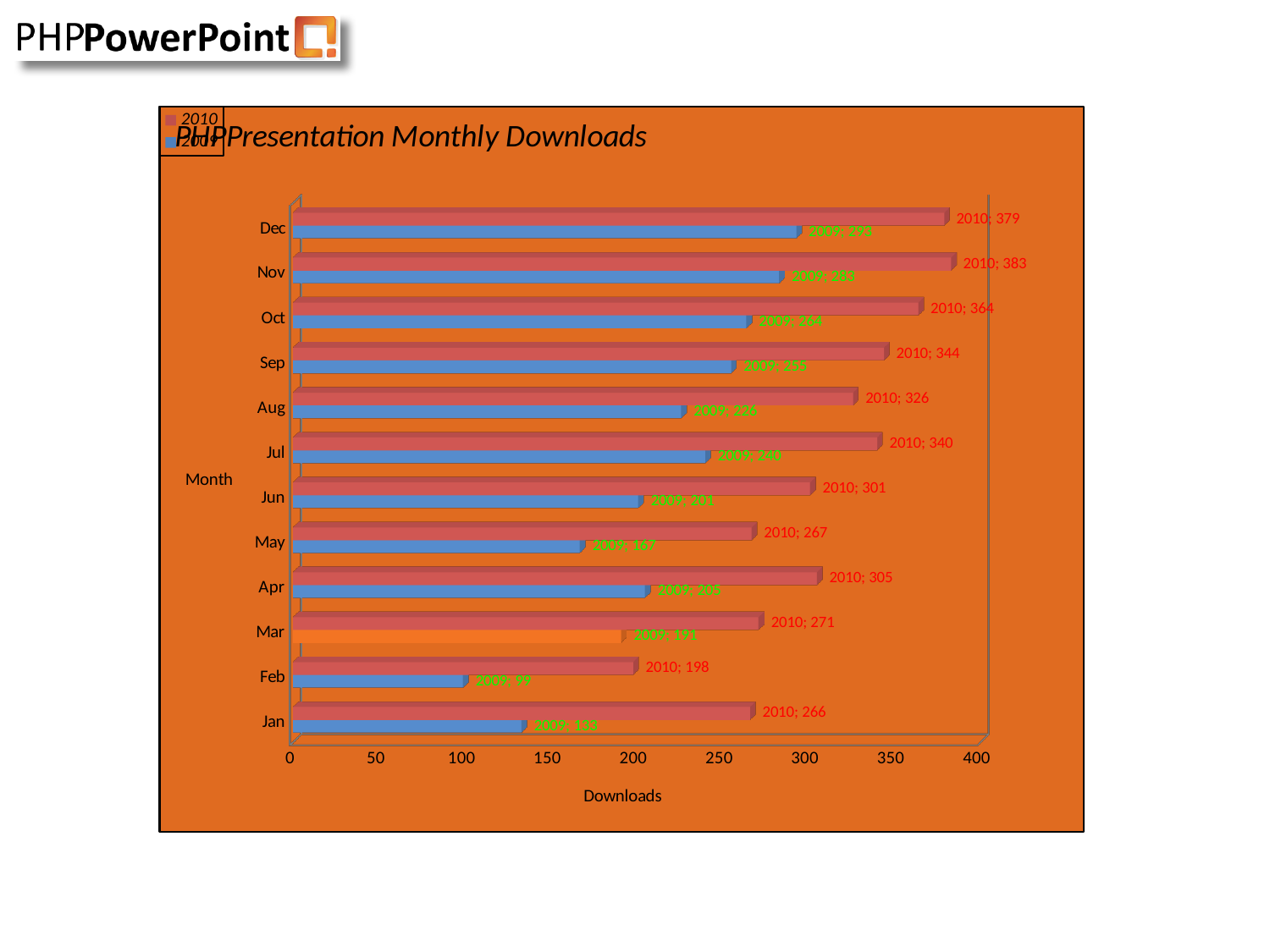
How many months are shown on the chart? 12 What is the 2010 value for Jul? 340 Which is larger, the 2010 value for Apr or the 2010 value for Jun? Apr What is the 2009 value for Feb? 99 How many series does the legend list? 2 What kind of chart is shown? bar chart Which month has the lowest 2009 value? Feb What is the 2010 value for Nov? 383 Which month has the highest 2010 value? Nov What is the difference between the 2010 and 2009 values for Dec? 86 Is the 2009 value for Sep greater or less than 200? greater What is the title of the chart? PHPPresentation Monthly Downloads